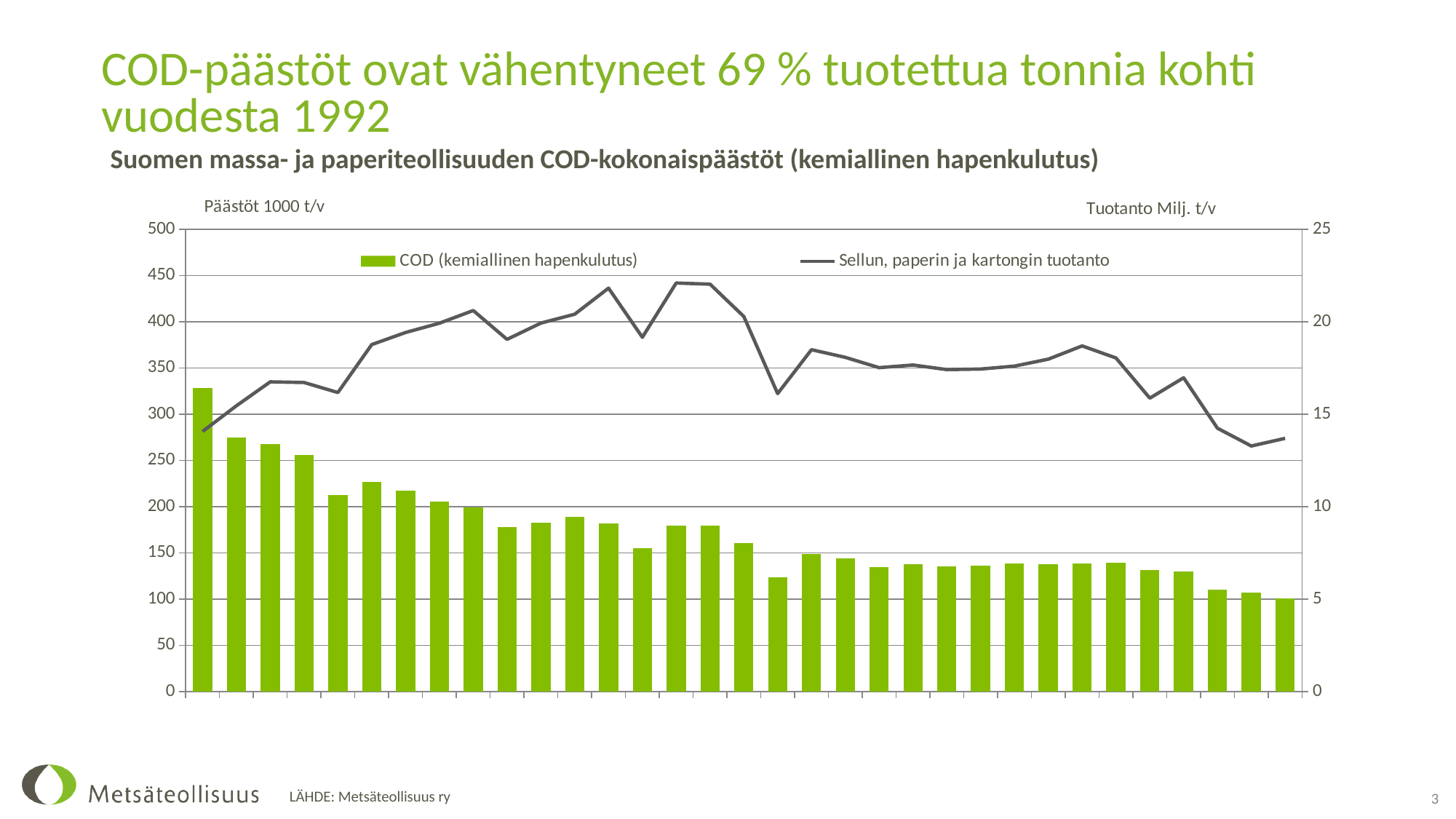
How many bars are plotted in the chart? 33 Is the highest point of the production line greater or less than 20 on the right-hand axis? greater Is the value of the first (leftmost) COD bar greater or less than 300? greater Which bar is the highest in the chart, the first (leftmost) or the last (rightmost)? The first (leftmost) Is the value of the last (rightmost) COD bar greater or less than 150? less How many series does the chart legend list? 2 Which is larger, the first (leftmost) COD bar or the last (rightmost) COD bar? The first (leftmost) bar What kind of chart is shown on the slide? A combined bar and line chart Which series is drawn as a line in the chart? Sellun, paperin ja kartongin tuotanto Do the COD bars generally rise or fall from left to right along the x axis? Fall Which series is drawn as bars in the chart? COD (kemiallinen hapenkulutus)